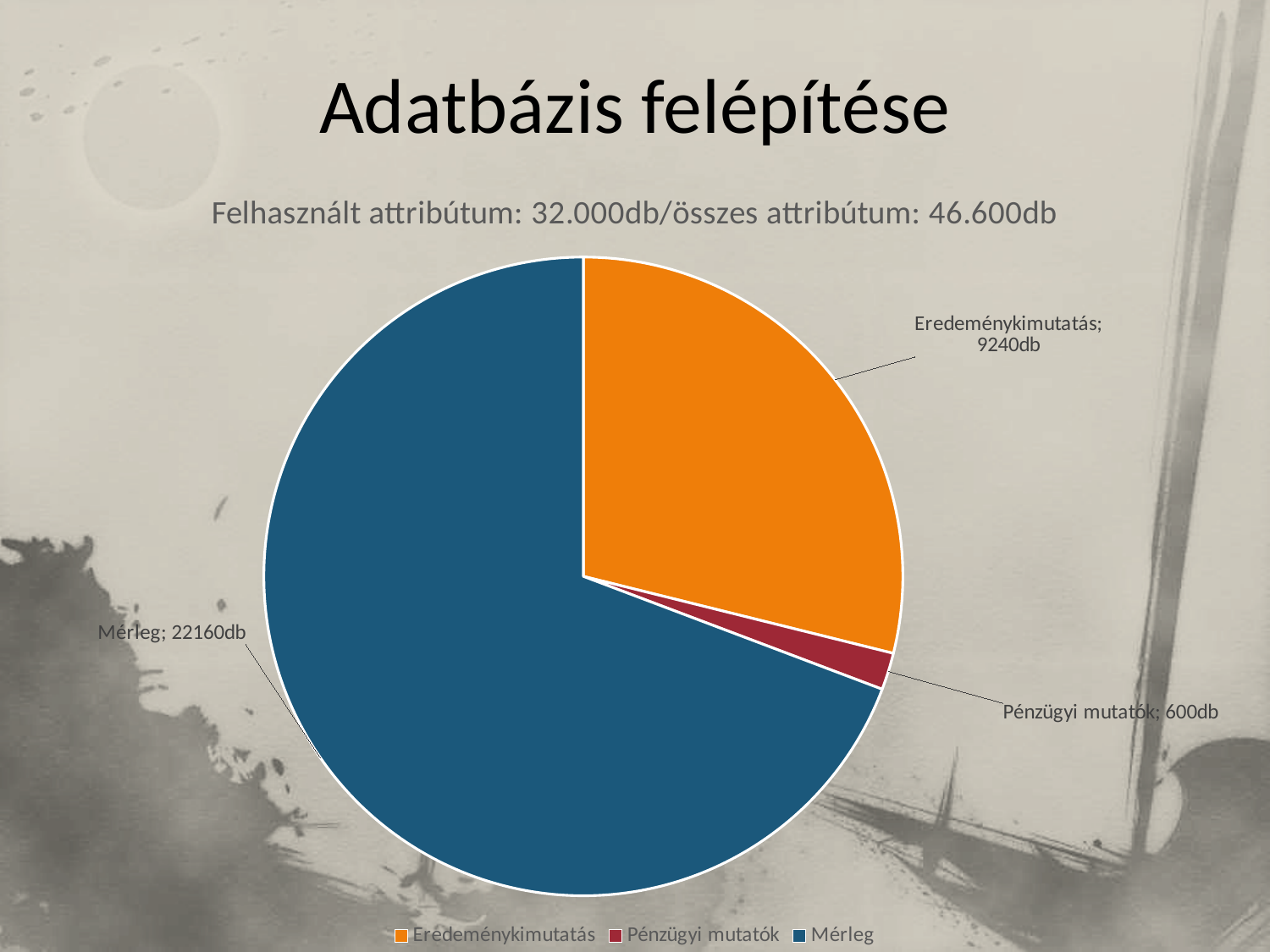
What is the value for Eredeménykimutatás? 9240db Which colour represents Mérleg in the pie chart? blue Which is larger, the value for Eredeménykimutatás or the value for Pénzügyi mutatók? Eredeménykimutatás Which category has the smallest slice of the pie? Pénzügyi mutatók Which category has the largest slice of the pie? Mérleg What kind of chart is shown on the slide? pie chart What is the difference between the values for Eredeménykimutatás and Pénzügyi mutatók? 8640db What is the difference between the values for Mérleg and Eredeménykimutatás? 12920db How many slices does the pie chart have? 3 What is the value for Pénzügyi mutatók? 600db What is the title of the chart? Felhasznált attribútum: 32.000db/összes attribútum: 46.600db What is the value for Mérleg? 22160db